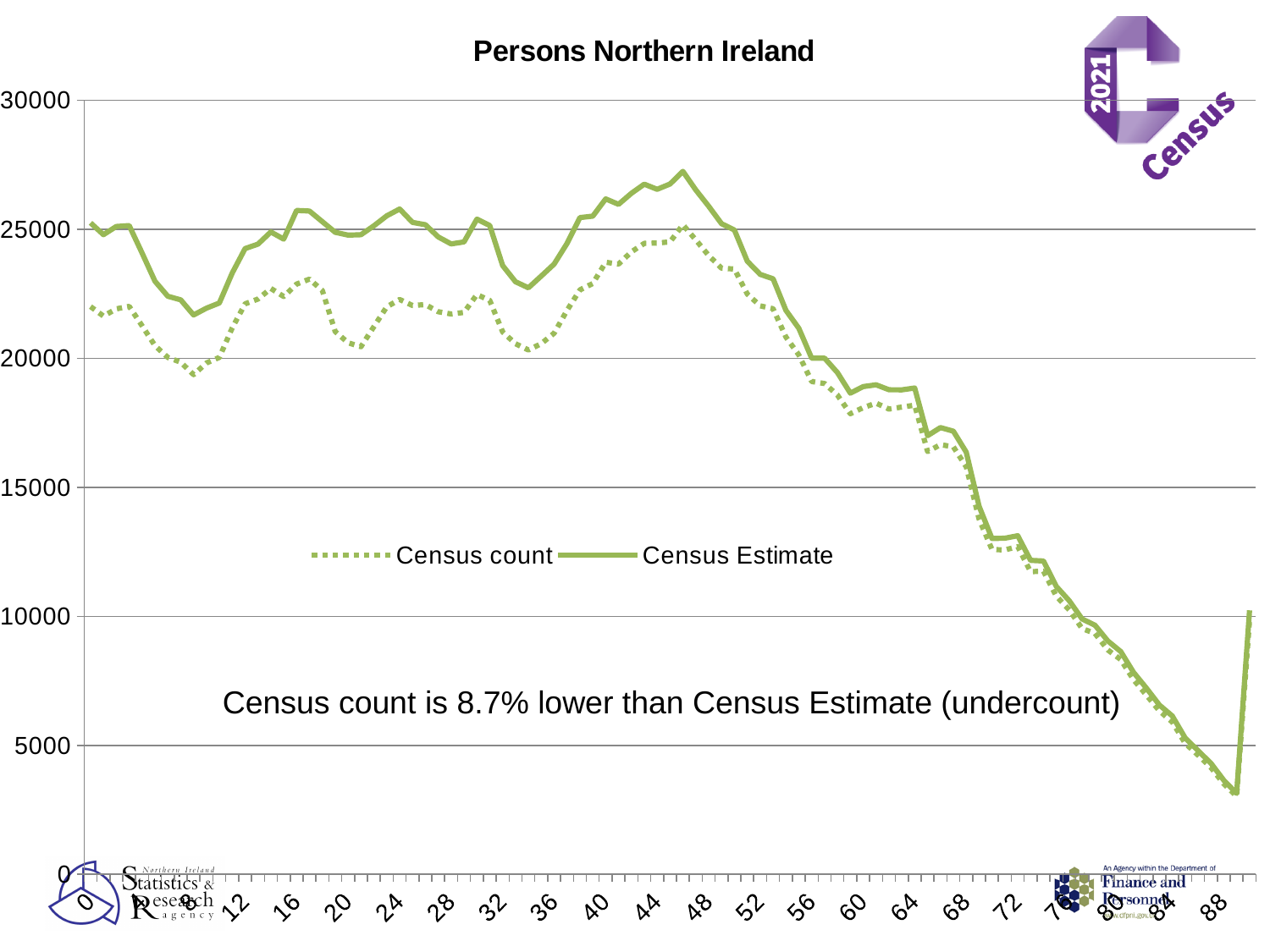
How many series does the legend list? 2 Is the Census Estimate value at age 64 greater or less than 20000? less What is the title of the chart? Persons Northern Ireland Is the Census count value at age 88 greater or less than 5000? less Is the Census Estimate value at age 44 greater or less than 25000? greater At age 40, which series has the higher value, Census count or Census Estimate? Census Estimate What kind of chart is shown on the slide? line chart Do the Census Estimate values rise or fall between age 48 and age 88? fall According to the text on the slide, by what percentage is the Census count lower than the Census Estimate? 8.7%